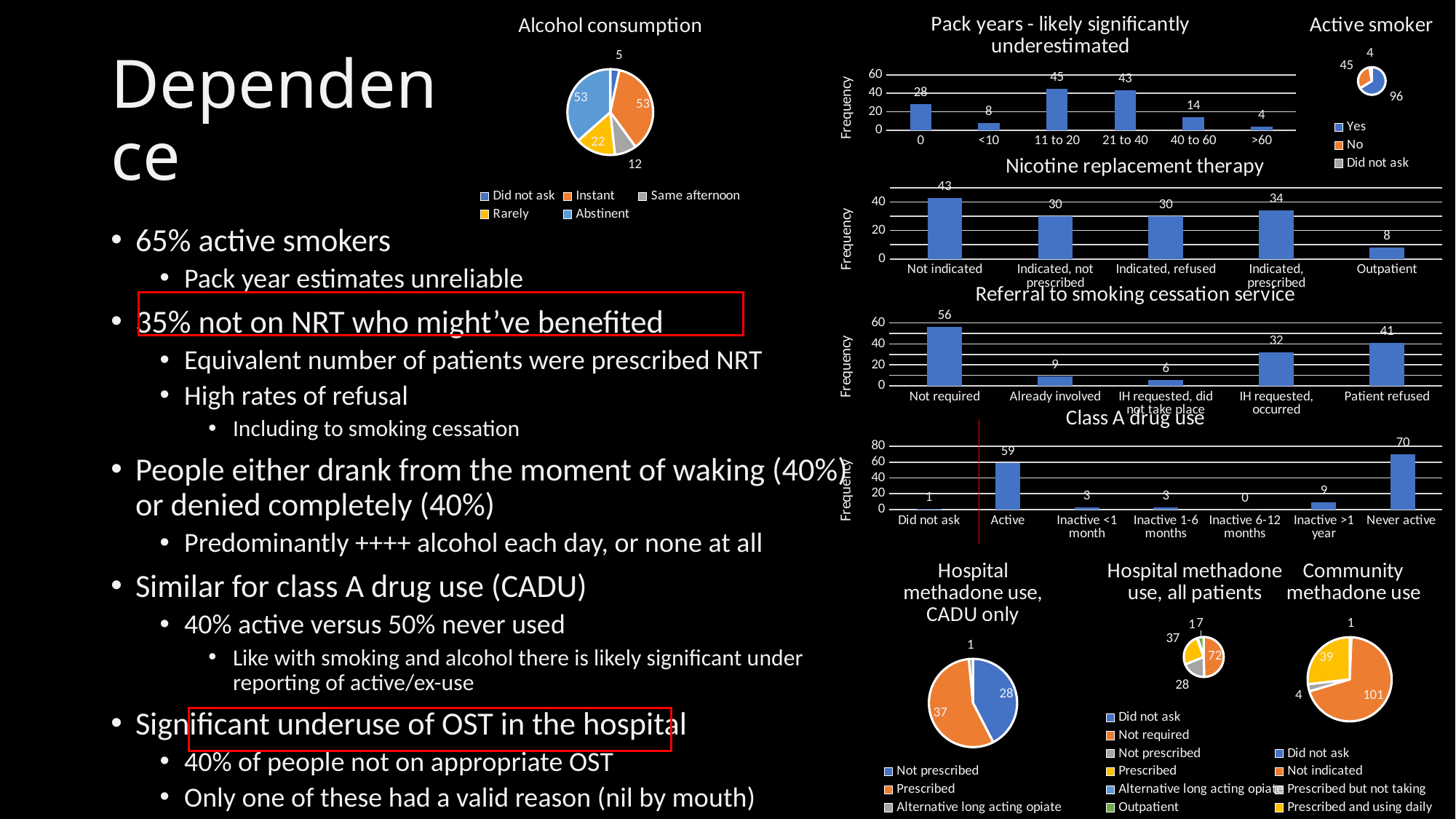
In the 'Referral to smoking cessation service' chart, what is the frequency for 'Patient refused'? 41 In the 'Nicotine replacement therapy' chart, what is the frequency for 'Not indicated'? 43 In the 'Pack years' bar chart, what is the frequency for the '11 to 20' category? 45 How many categories are shown on the x axis of the 'Class A drug use' chart? 7 In the 'Class A drug use' chart, what is the frequency for 'Inactive >1 year'? 9 In the 'Referral to smoking cessation service' chart, which category has the highest frequency? Not required In the 'Pack years' bar chart, which category has the lowest frequency? >60 In the 'Hospital methadone use, CADU only' pie chart, what is the value for 'Prescribed'? 37 How many entries does the legend of the 'Alcohol consumption' pie chart list? 5 In the 'Alcohol consumption' pie chart, what is the value for 'Rarely'? 22 In the 'Class A drug use' chart, which is larger: 'Active' or 'Never active'? Never active In the 'Nicotine replacement therapy' chart, what is the difference between 'Indicated, prescribed' and 'Outpatient'? 26